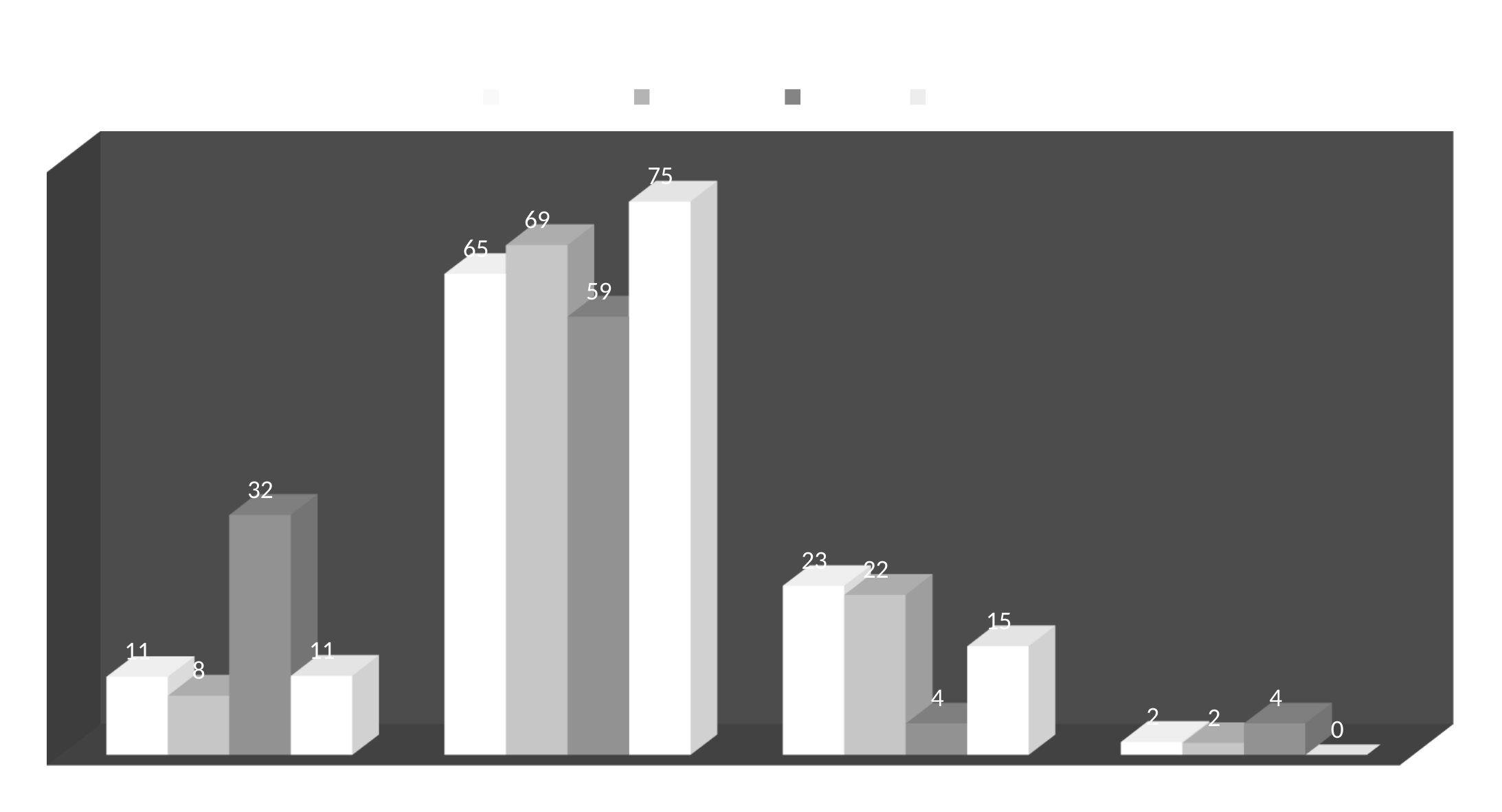
What is the value of the third bar in the leftmost group? 32 What is the total of the four bars in the second group from the left? 268 What kind of chart is shown on the slide? bar chart What is the value of the fourth bar in the second group from the left? 75 What is the lowest value labelled on the chart? 0 How many groups of bars are plotted along the x axis? 4 In the third group from the left, which is larger: the first bar or the fourth bar? the first bar How many series does the legend list? 4 In the second group from the left, what is the difference between the second bar (69) and the first bar (65)? 4 In the leftmost group, what is the difference between the third bar (32) and the second bar (8)? 24 What is the value of the third bar in the third group from the left? 4 What is the highest value labelled on the chart? 75